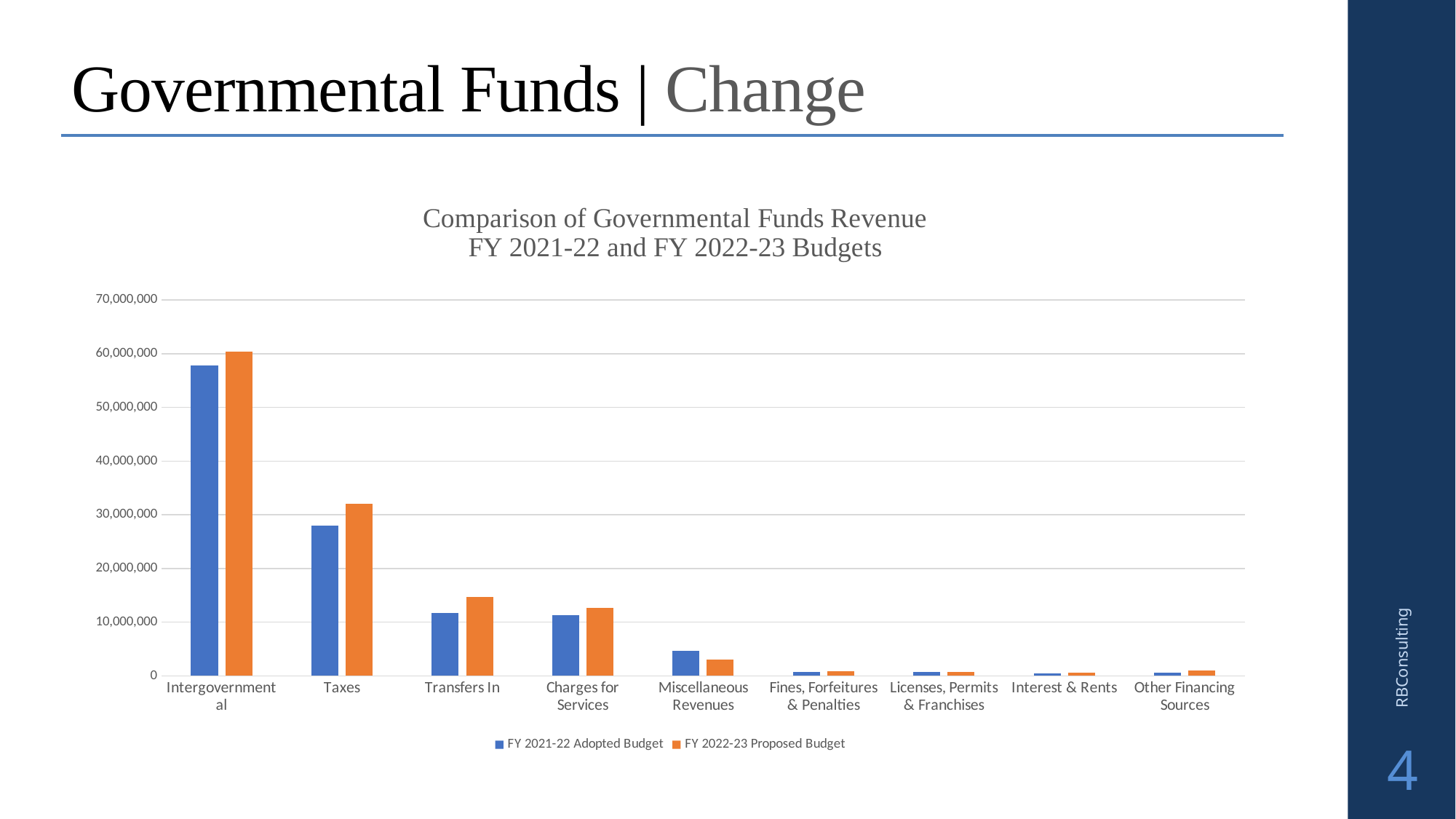
How many series does the chart's legend list? 2 For Miscellaneous Revenues, which is larger: the FY 2021-22 Adopted Budget or the FY 2022-23 Proposed Budget? FY 2021-22 Adopted Budget Which category has the highest FY 2021-22 Adopted Budget value? Intergovernmental For Transfers In, which is larger: the FY 2021-22 Adopted Budget or the FY 2022-23 Proposed Budget? FY 2022-23 Proposed Budget Is the FY 2021-22 Adopted Budget value for Miscellaneous Revenues greater or less than 10,000,000? less What colour represents the FY 2022-23 Proposed Budget series in the chart? orange Is the FY 2022-23 Proposed Budget value for Taxes greater or less than 30,000,000? greater Is the FY 2021-22 Adopted Budget value for Taxes greater or less than 30,000,000? less How many revenue categories are shown on the x axis of the chart? 9 What type of chart is shown on the slide? bar chart Which category has the highest FY 2022-23 Proposed Budget value? Intergovernmental